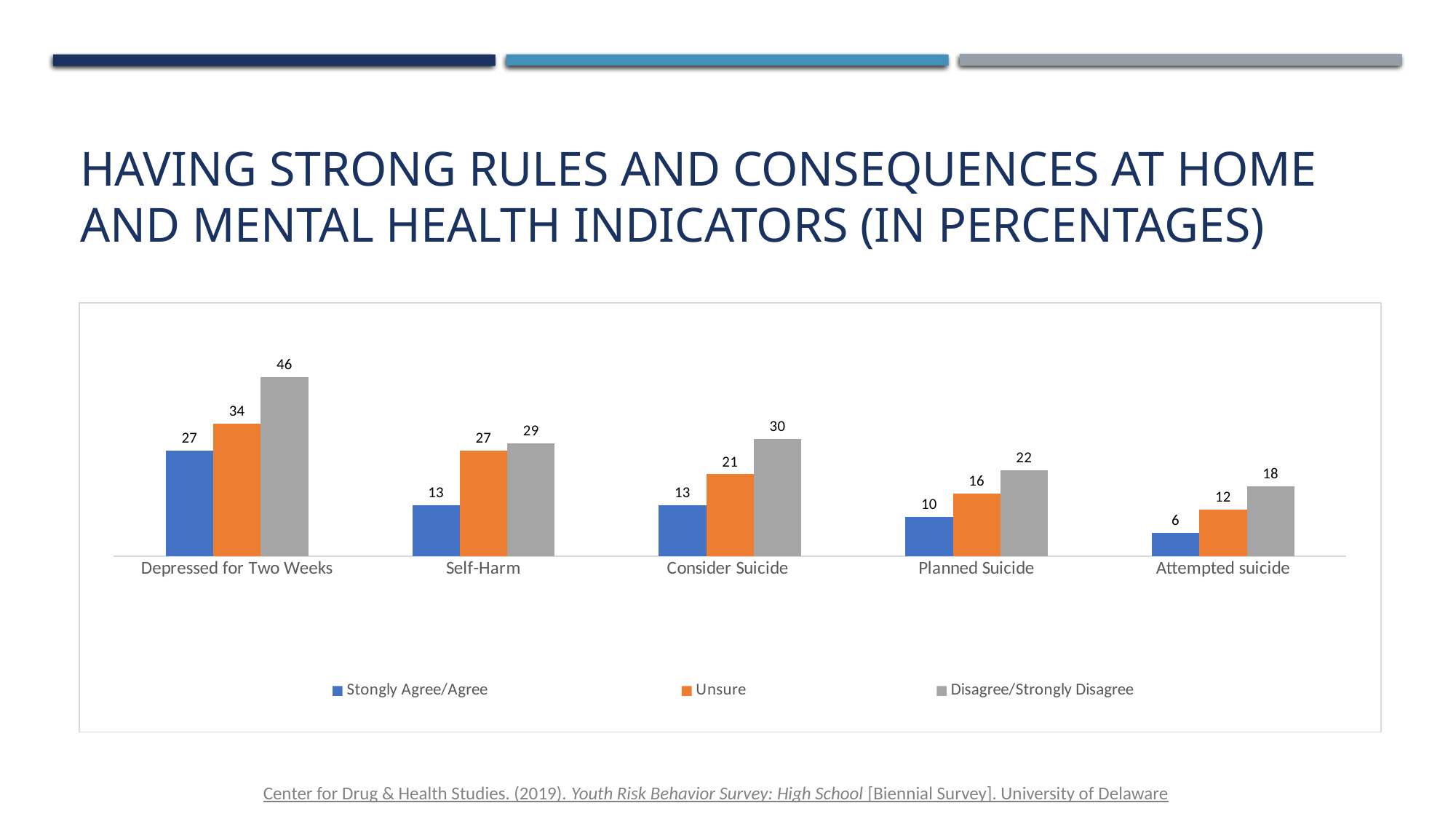
What kind of chart is shown on the slide? Bar chart What is the value for Stongly Agree/Agree in the Attempted suicide category? 6 What is the value for Unsure in the Consider Suicide category? 21 Which category has the lowest Stongly Agree/Agree value? Attempted suicide How many categories are shown on the x axis? 5 Which is larger for Planned Suicide: the Unsure value or the Disagree/Strongly Disagree value? Disagree/Strongly Disagree How many series does the legend list? 3 What is the difference between the Disagree/Strongly Disagree and Stongly Agree/Agree values for Depressed for Two Weeks? 19 Which category has the highest Disagree/Strongly Disagree value? Depressed for Two Weeks What is the difference between the Unsure and Stongly Agree/Agree values for Self-Harm? 14 What is the value for Disagree/Strongly Disagree in the Depressed for Two Weeks category? 46 Which colour represents the Unsure series? Orange